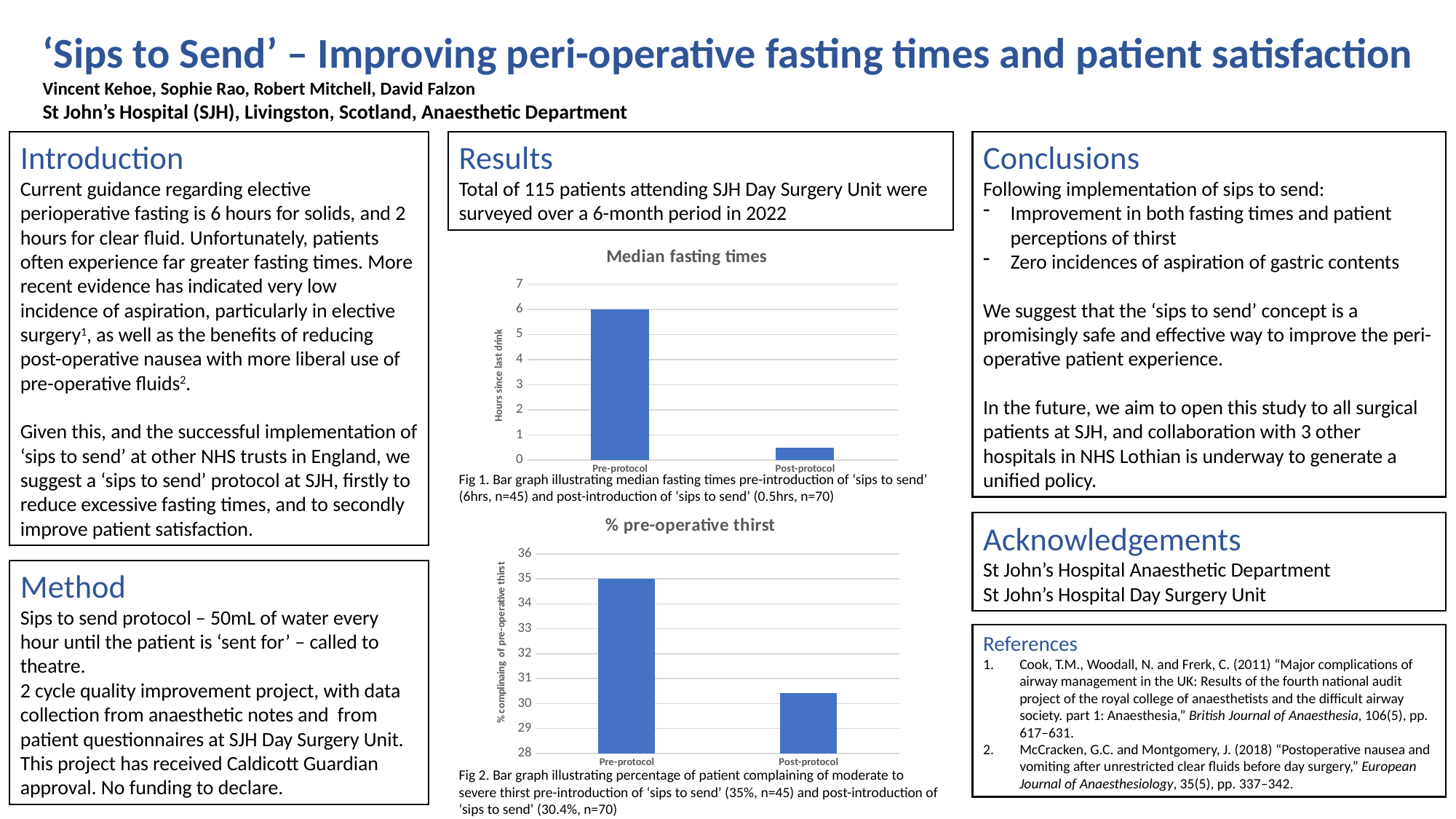
In the 'Median fasting times' chart, is the value for Post-protocol greater or less than 1? less In the '% pre-operative thirst' chart, which category has the highest value? Pre-protocol In the 'Median fasting times' chart, how many categories are shown on the x axis? 2 What kind of chart is the 'Median fasting times' chart? bar chart In the 'Median fasting times' chart, is the value for Pre-protocol greater or less than 5? greater In the 'Median fasting times' chart, what is the y-axis label? Hours since last drink In the 'Median fasting times' chart, what is the value for Pre-protocol? 6 In the '% pre-operative thirst' chart, do the values rise or fall from Pre-protocol to Post-protocol? fall In the '% pre-operative thirst' chart, what is the value for Pre-protocol? 35 In the 'Median fasting times' chart, which category has the lowest value? Post-protocol In the '% pre-operative thirst' chart, is the value for Post-protocol greater or less than 31? less In the '% pre-operative thirst' chart, which is larger, Pre-protocol or Post-protocol? Pre-protocol